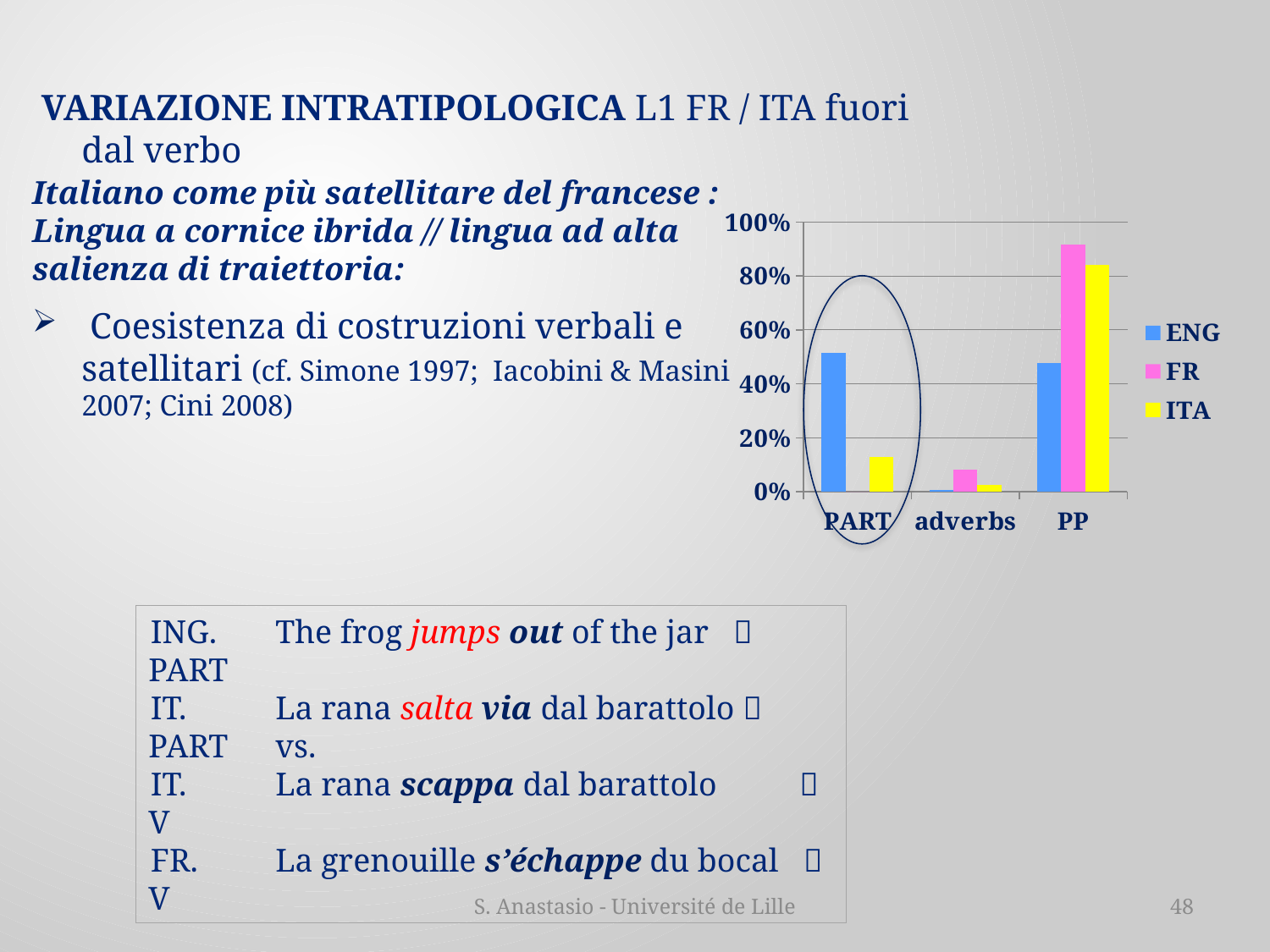
Is the value for FR in the PP category greater or less than 80%? greater Which is larger in the PP category, the ENG value or the ITA value? ITA Which series has the lowest value in the PART category? FR Is the value for ITA in the adverbs category greater or less than 20%? less Which series has the highest value in the PART category? ENG How many series does the chart legend list? 3 Which series has the highest value in the PP category? FR How many categories are shown on the x axis of the chart? 3 Is the value for ENG in the PART category greater or less than 40%? greater What kind of chart is shown on the slide? bar chart Which colour represents the ITA series in the chart? yellow Which category has the highest FR value? PP